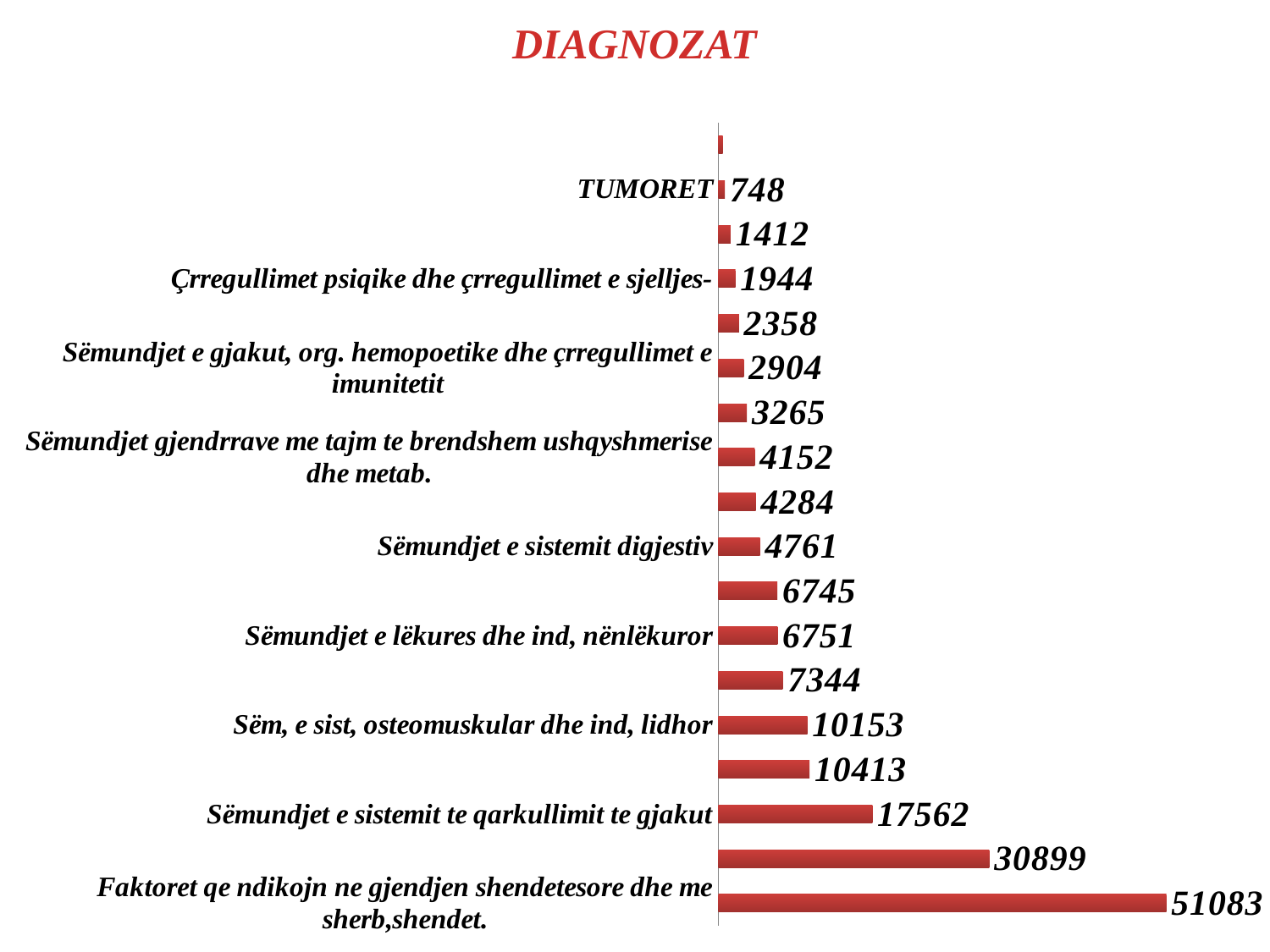
What is the value for Sëmundjet e sistemit te qarkullimit te gjakut? 17562 What is the difference between the value for Faktoret qe ndikojn ne gjendjen shendetesore dhe me sherb,shendet. and the value for Sëmundjet e sistemit te qarkullimit te gjakut? 33521 What is the value for Sëm, e sist, osteomuskular dhe ind, lidhor? 10153 Which category has the highest value? Faktoret qe ndikojn ne gjendjen shendetesore dhe me sherb,shendet. What is the title of the chart? DIAGNOZAT What is the difference between the value for Sëm, e sist, osteomuskular dhe ind, lidhor and the value for Sëmundjet e sistemit digjestiv? 5392 What is the value for TUMORET? 748 What is the value for Sëmundjet e lëkures dhe ind, nënlëkuror? 6751 What is the value for Sëmundjet e sistemit digjestiv? 4761 Which is larger: the value for Sëmundjet e lëkures dhe ind, nënlëkuror or the value for Sëmundjet e sistemit digjestiv? Sëmundjet e lëkures dhe ind, nënlëkuror What kind of chart is shown on the slide? Bar chart What is the value for Çrregullimet psiqike dhe çrregullimet e sjelljes? 1944